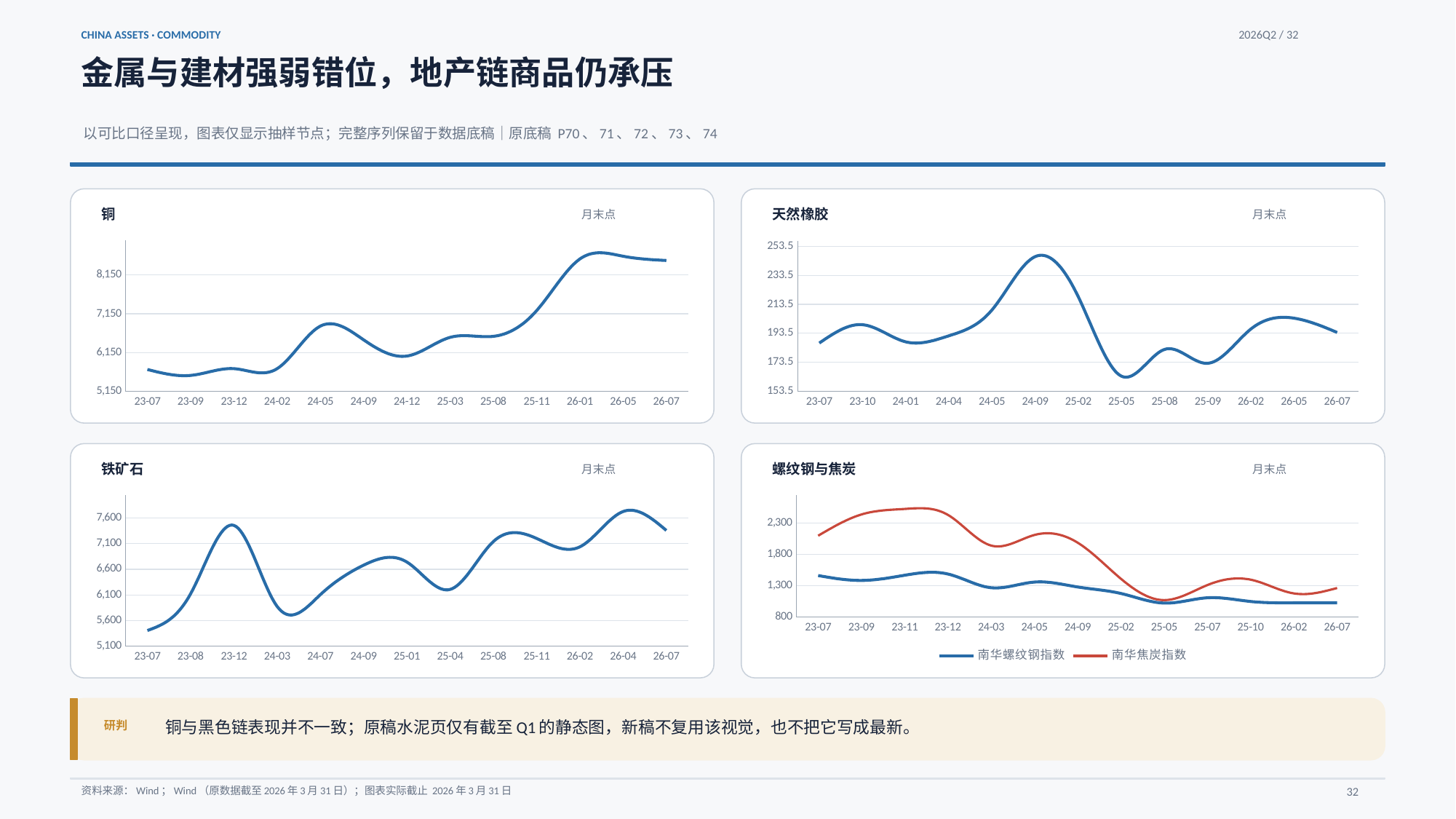
In the 天然橡胶 chart, at which x-axis point is the value lowest? 25-05 What kind of chart is the 铜 chart? line chart In the 铜 chart, is the value at 26-01 greater or less than 8,150? greater In the 螺纹钢与焦炭 chart, which series has the higher value at 23-12, 南华螺纹钢指数 or 南华焦炭指数? 南华焦炭指数 In the 天然橡胶 chart, is the value at 25-05 greater or less than 173.5? less How many series does the legend of the 螺纹钢与焦炭 chart list? 2 How many points are plotted on the x axis of the 铁矿石 chart? 13 In the 天然橡胶 chart, at which x-axis point is the value highest? 24-09 In the 铜 chart, is the value at 23-07 greater or less than 6,150? less In the 铜 chart, does the value overall rise or fall from 23-07 to 26-07? rise In the 螺纹钢与焦炭 chart, which series is shown in red? 南华焦炭指数